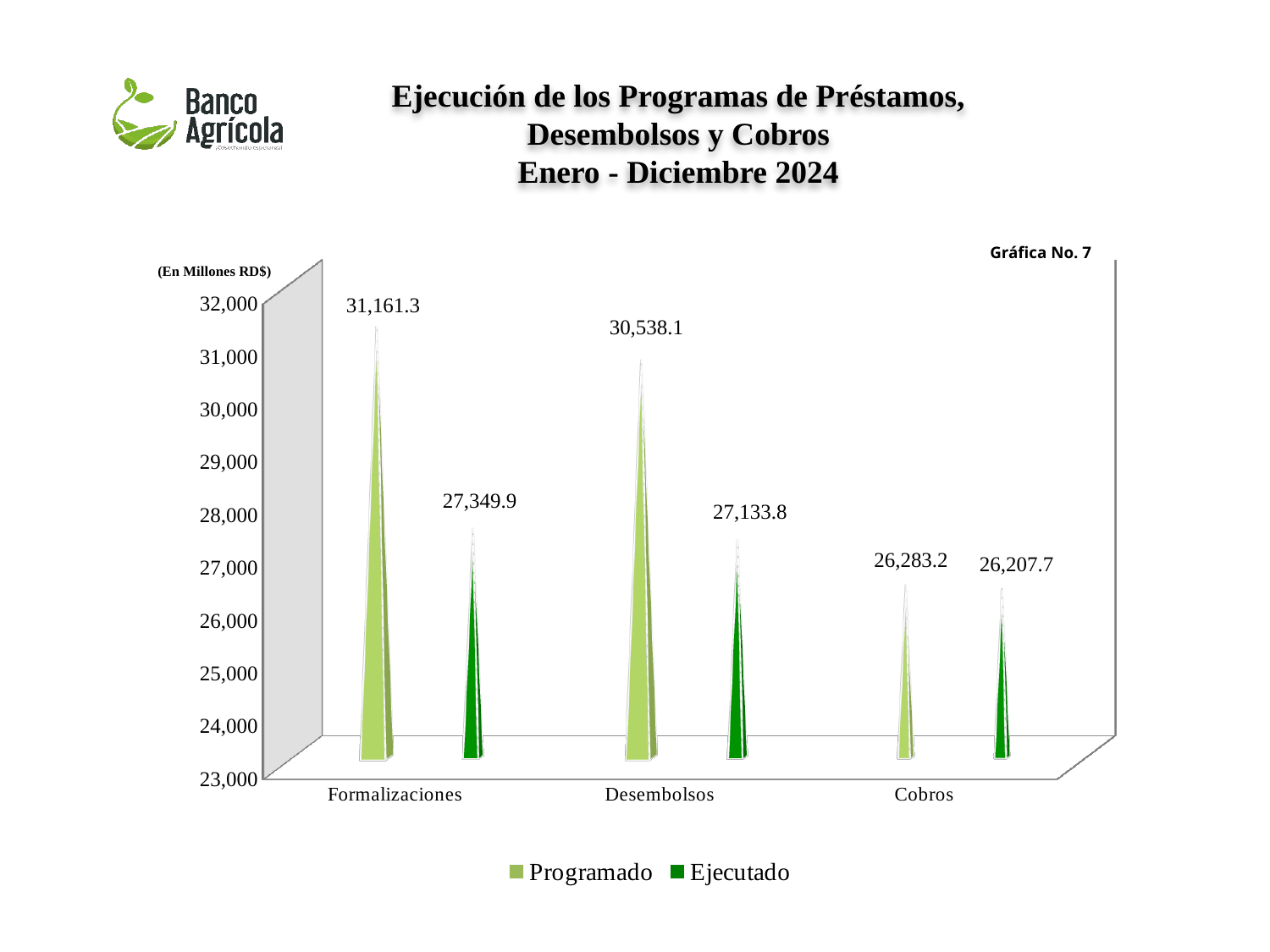
What is the difference between the Programado and Ejecutado values for Cobros? 75.5 Which category has the lowest Ejecutado value? Cobros Which is larger for Desembolsos, the Programado value or the Ejecutado value? Programado What is the Ejecutado value for Desembolsos? 27,133.8 How many categories are shown on the x axis? 3 What is the Programado value for Formalizaciones? 31,161.3 What is the Ejecutado value for Cobros? 26,207.7 What unit is stated for the values in the chart? En Millones RD$ Do the Programado values rise or fall from Formalizaciones to Cobros? fall Which category has the highest Programado value? Formalizaciones How many series does the legend list? 2 What is the difference between the Programado and Ejecutado values for Formalizaciones? 3,811.4